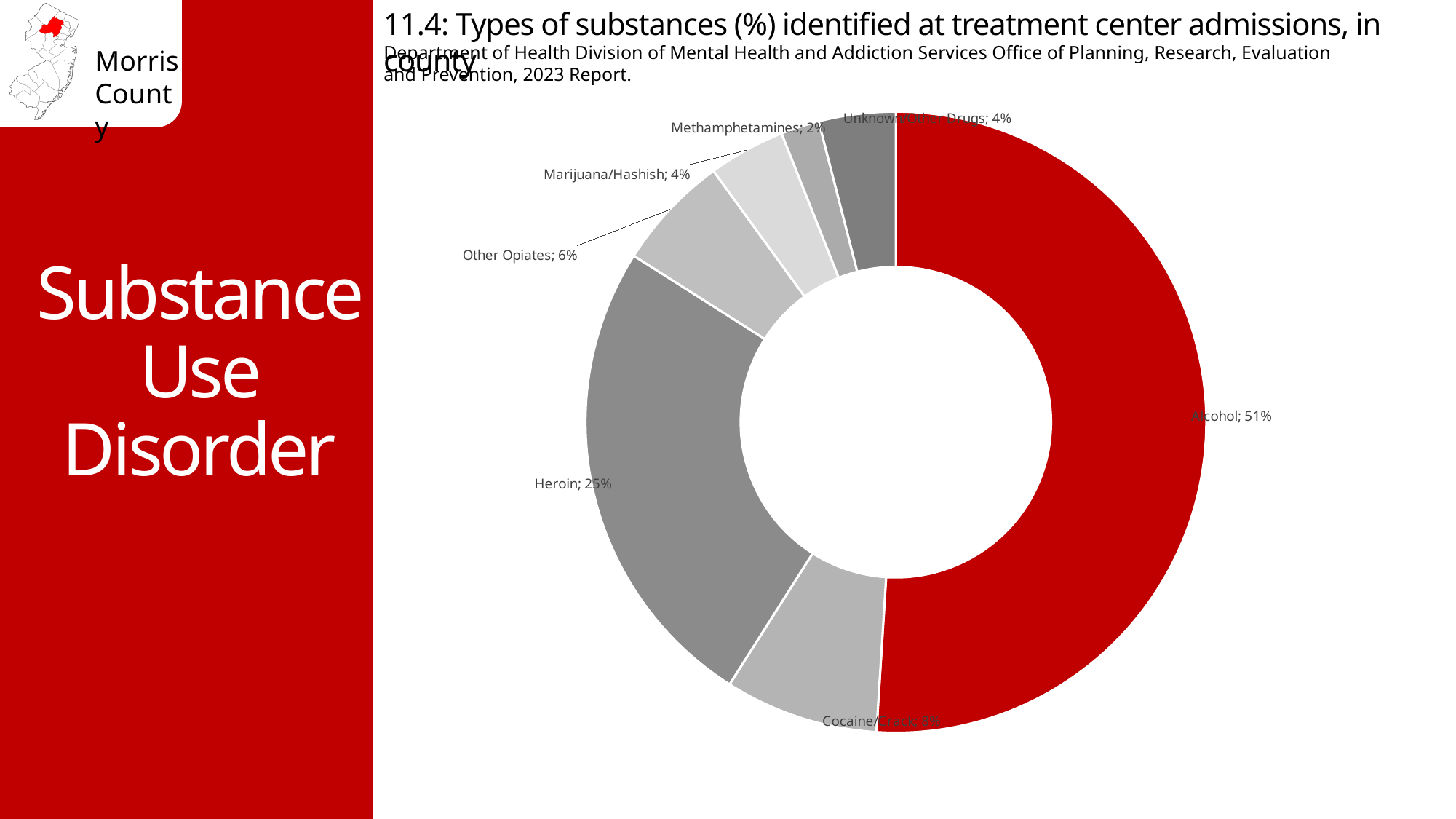
What is the difference in percentage points between Alcohol and Heroin? 26 Which slice of the chart is coloured red? Alcohol What percentage is shown for Heroin? 25% Which substance has the smallest share of admissions? Methamphetamines What percentage of treatment center admissions is attributed to Alcohol? 51% Which substance has the largest share of admissions? Alcohol How many substance categories are shown in the chart? 7 What is the value for Cocaine/Crack? 8% What percentage is shown for Other Opiates? 6% What kind of chart is used on this slide? Doughnut (pie) chart What is the value for Methamphetamines? 2% Which is larger, the share for Cocaine/Crack or the share for Other Opiates? Cocaine/Crack